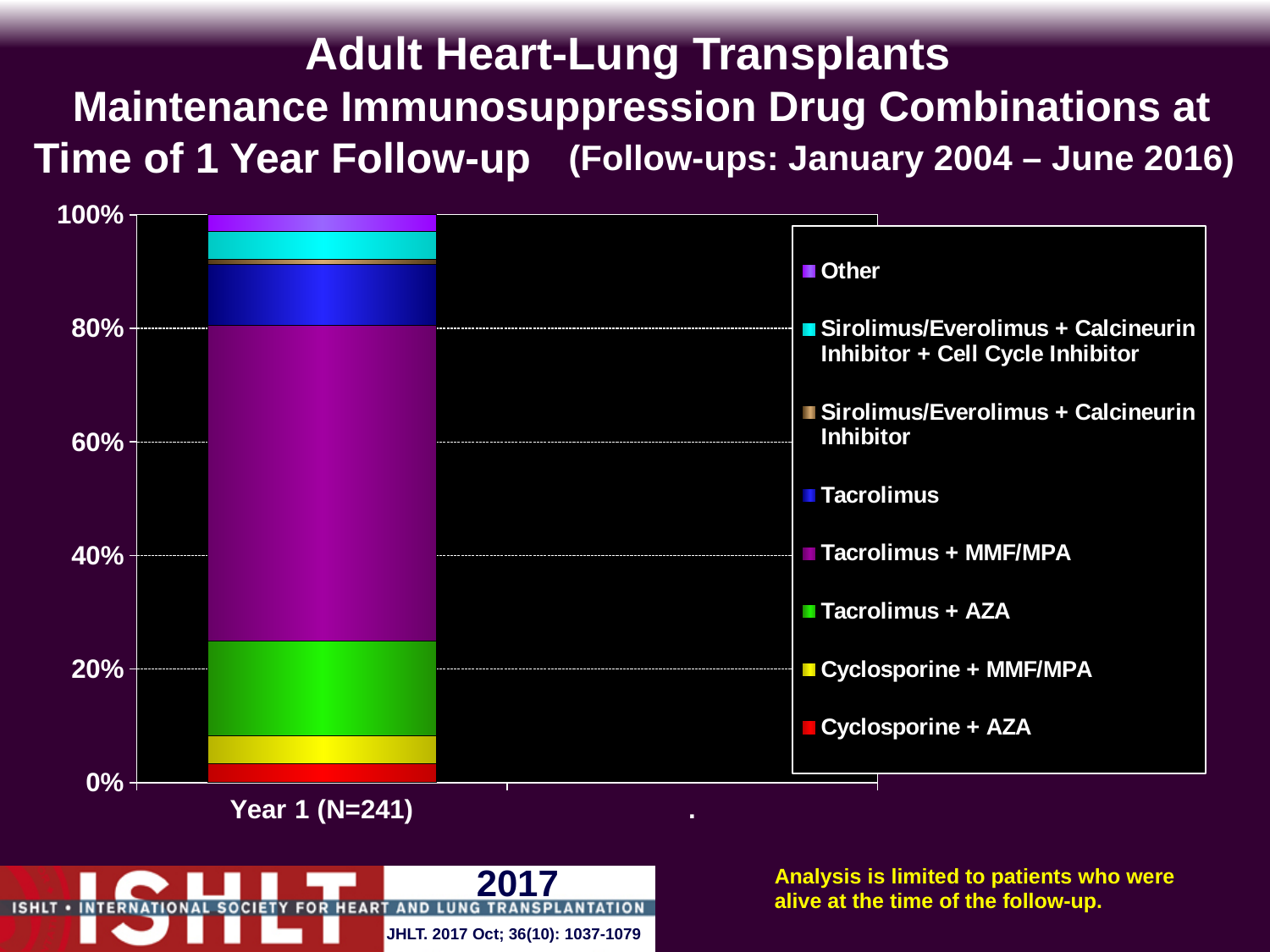
What kind of chart is shown on the slide? Stacked bar chart Which segment is larger in the Year 1 bar: Tacrolimus + AZA or Cyclosporine + MMF/MPA? Tacrolimus + AZA How many series does the legend list? 8 What is the label of the single category on the x axis? Year 1 (N=241) Which drug combination occupies the largest segment of the Year 1 bar? Tacrolimus + MMF/MPA What is the total height of the stacked Year 1 bar on the percentage axis? 100% Which legend entry is listed first (at the top) in the legend? Other Which drug combination occupies the smallest segment of the Year 1 bar? Sirolimus/Everolimus + Calcineurin Inhibitor Is the share for Cyclosporine + AZA in the Year 1 bar greater or less than 20%? less How many bars (categories) are plotted on the x axis? 1 Is the share for Tacrolimus + MMF/MPA in the Year 1 bar greater or less than 40%? greater Which segment is larger in the Year 1 bar: Tacrolimus or Other? Tacrolimus